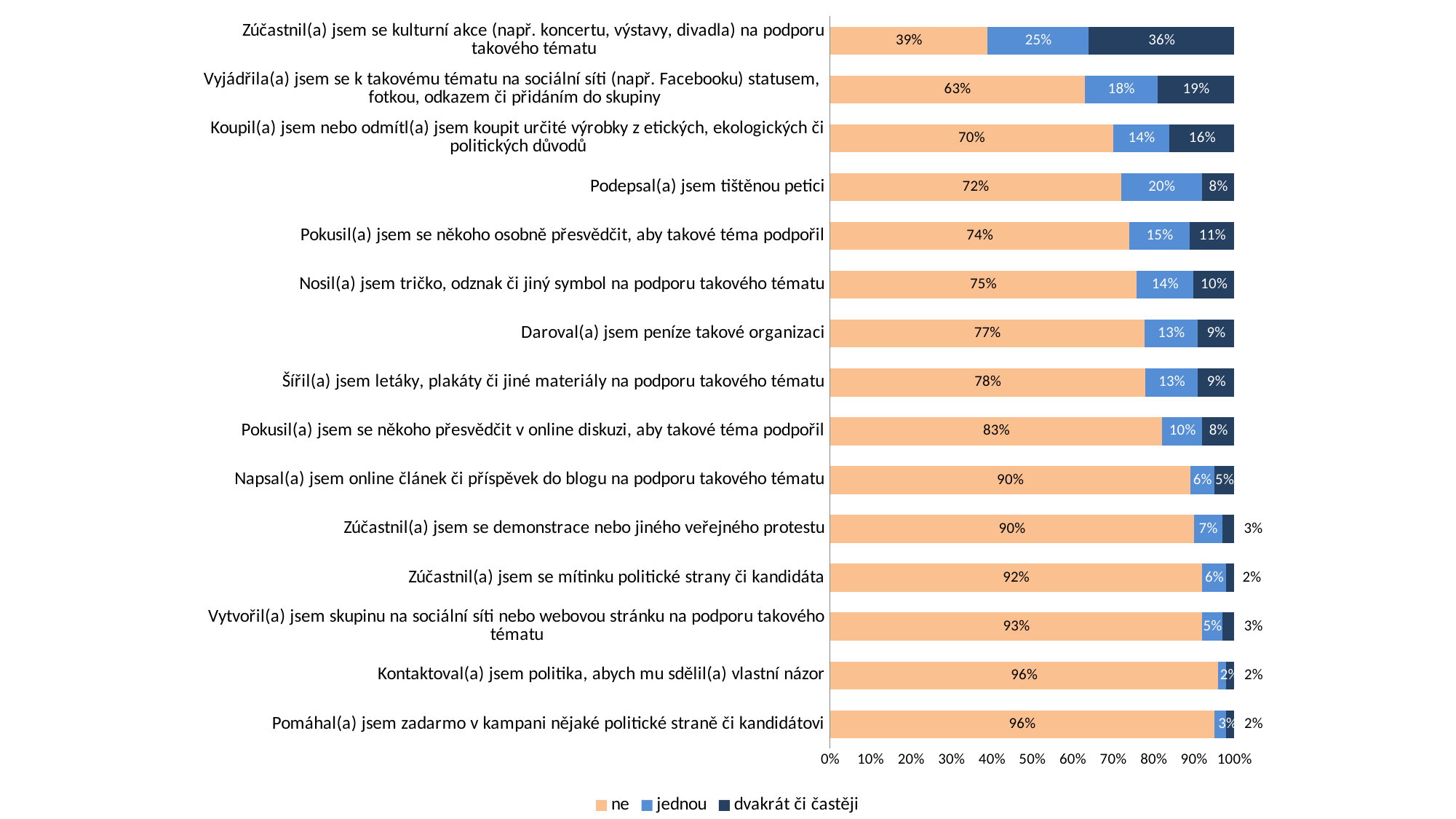
What kind of chart is shown on the slide? stacked bar chart Which legend entry is shown in the darkest colour? dvakrát či častěji How many categories (activities) are plotted in the chart? 15 How many series does the legend list? 3 What is the total of the stacked bar for 'Zúčastnil(a) jsem se kulturní akce (např. koncertu, výstavy, divadla) na podporu takového tématu'? 100% What is the value of 'jednou' for 'Vyjádřila(a) jsem se k takovému tématu na sociální síti (např. Facebooku) statusem, fotkou, odkazem či přidáním do skupiny'? 18% Which is larger: the 'jednou' value for 'Podepsal(a) jsem tištěnou petici' or for 'Koupil(a) jsem nebo odmítl(a) jsem koupit určité výrobky z etických, ekologických či politických důvodů'? Podepsal(a) jsem tištěnou petici Which category has the lowest value for 'ne'? Zúčastnil(a) jsem se kulturní akce (např. koncertu, výstavy, divadla) na podporu takového tématu What is the value of 'ne' for 'Podepsal(a) jsem tištěnou petici'? 72% What is the difference between the 'ne' values for 'Pokusil(a) jsem se někoho přesvědčit v online diskuzi, aby takové téma podpořil' and 'Nosil(a) jsem tričko, odznak či jiný symbol na podporu takového tématu'? 8% Which category has the highest value for 'dvakrát či častěji'? Zúčastnil(a) jsem se kulturní akce (např. koncertu, výstavy, divadla) na podporu takového tématu What is the value of 'dvakrát či častěji' for 'Daroval(a) jsem peníze takové organizaci'? 9%